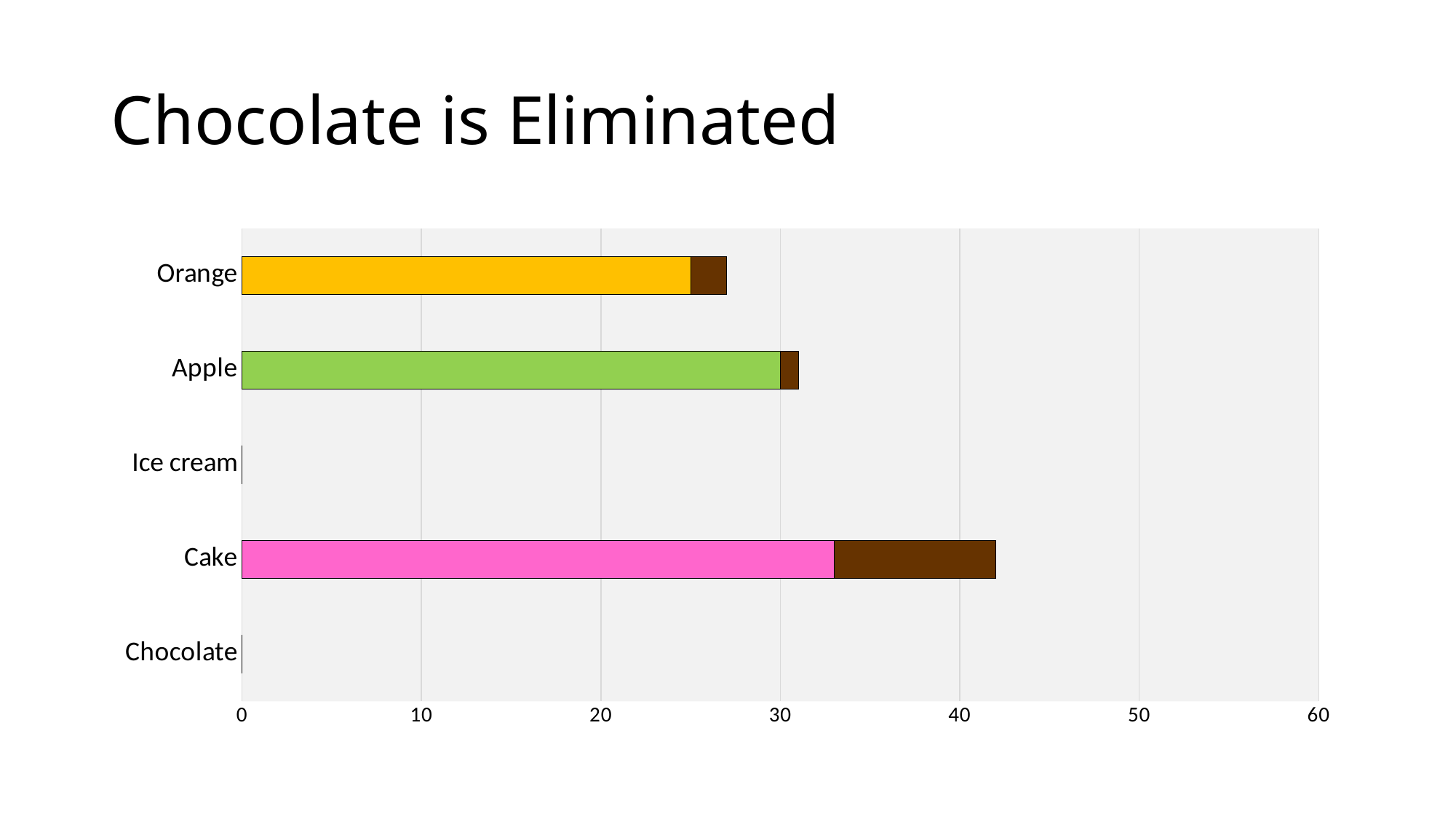
Is the total bar length for Apple greater or less than 20? greater Which categories show no bar at all in the chart? Ice cream and Chocolate Is the total bar length for Cake greater or less than 40? greater How many categories have a visible bar in the chart? 3 Is the total bar length for Cake greater or less than 50? less Which has the longer bar, Cake or Orange? Cake How many categories are listed on the vertical axis of the chart? 5 What kind of chart is shown on the slide? bar chart Which has the longer bar, Apple or Orange? Apple What is the title of the slide? Chocolate is Eliminated Which category has the longest bar in the chart? Cake